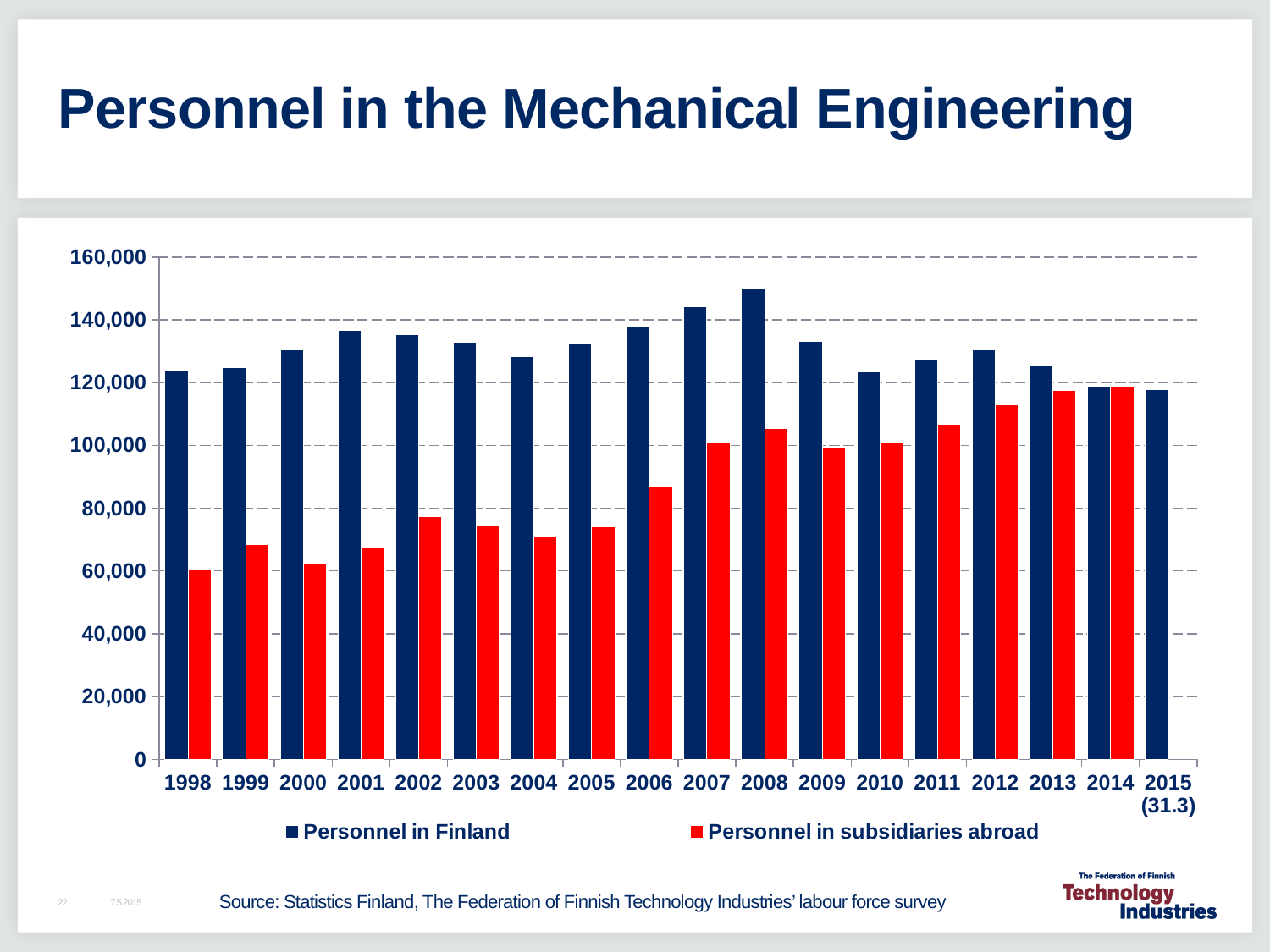
How many series does the legend list? 2 How many years are shown on the x axis? 18 Is the value for Personnel in subsidiaries abroad in 2012 greater or less than 100,000? greater Does the value for Personnel in subsidiaries abroad generally rise or fall from 1998 to 2014? rise Is the value for Personnel in subsidiaries abroad in 1998 greater or less than 80,000? less In which year is the value for Personnel in subsidiaries abroad lowest? 1998 Is the value for Personnel in Finland in 2008 greater or less than 140,000? greater In which year is the value for Personnel in Finland highest? 2008 What colour are the bars for Personnel in subsidiaries abroad? Red Which is larger: Personnel in subsidiaries abroad in 2002 or in 2012? 2012 What kind of chart is shown on the slide? Bar chart